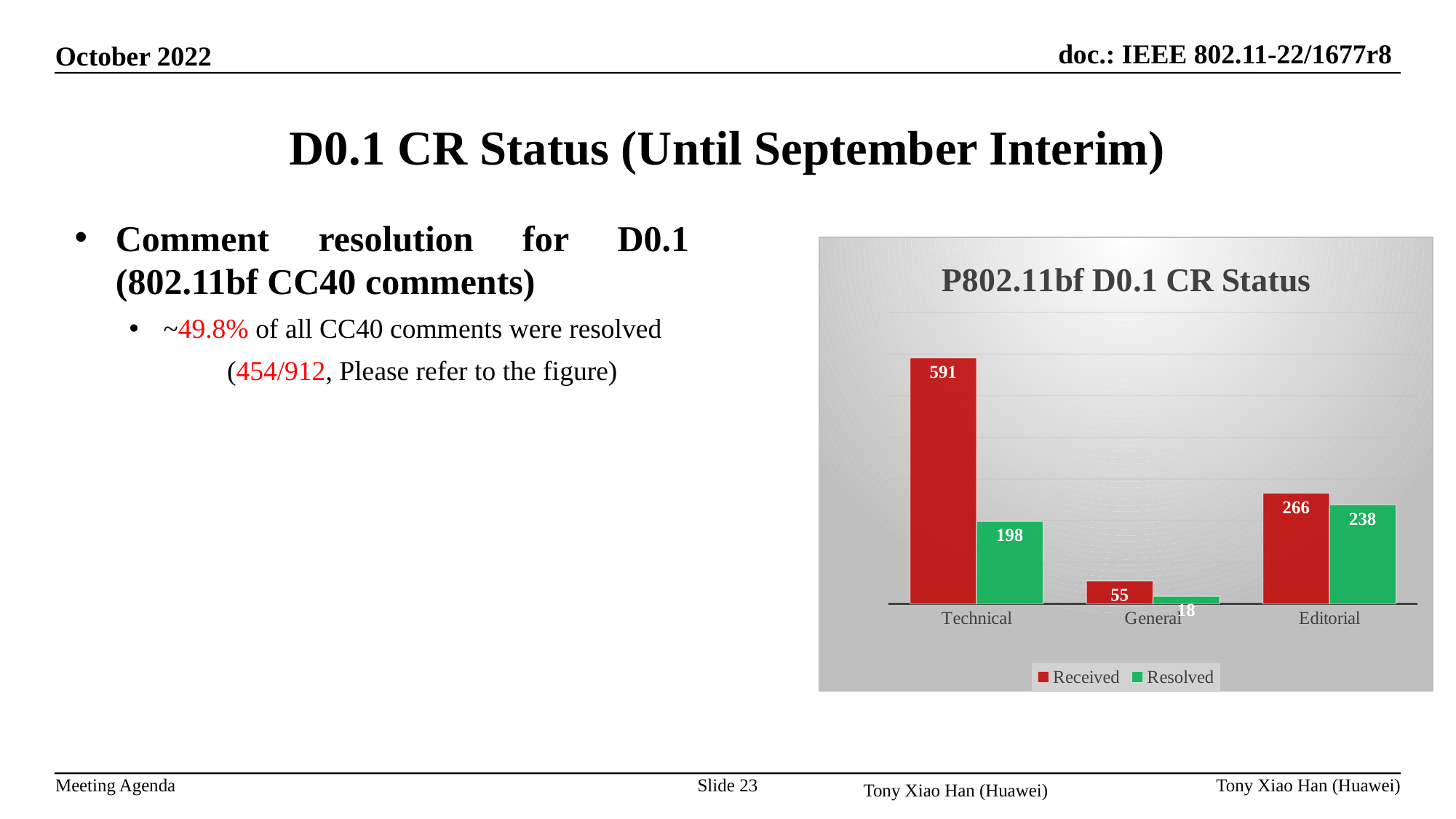
Which category has the lowest Resolved value? General What type of chart is shown on the slide? bar chart What is the Received value for Technical? 591 What is the difference between Received and Resolved for Technical? 393 What is the Resolved value for General? 18 What is the title of the chart? P802.11bf D0.1 CR Status How many categories are shown on the x axis? 3 What is the Resolved value for Editorial? 238 Which category has the highest Received value? Technical What is the difference between Received and Resolved for Editorial? 28 Which is larger for Editorial, Received or Resolved? Received How many series does the legend list? 2